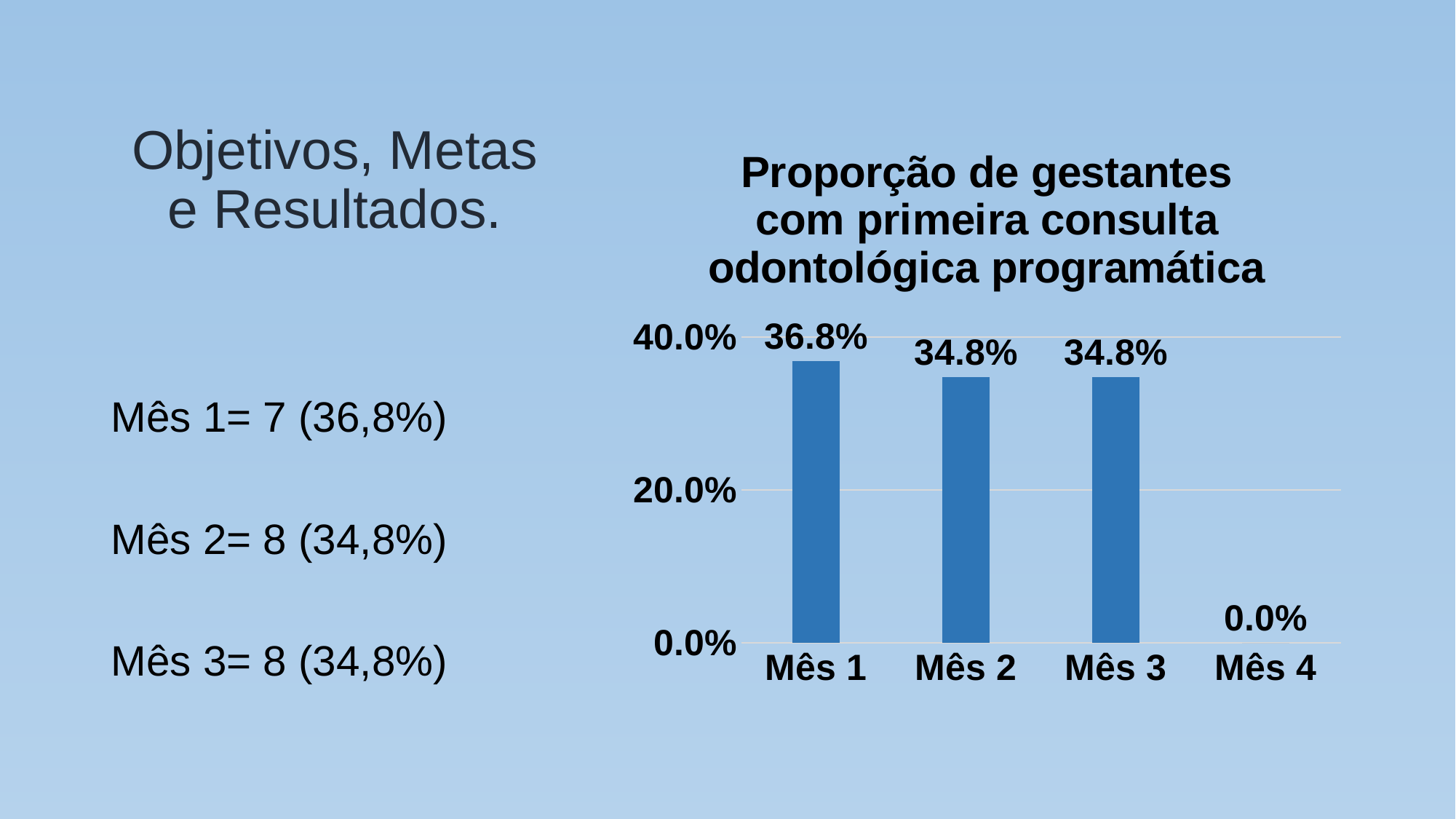
How many categories are shown on the x axis? 4 What is the value for Mês 4? 0.0% What is the title of the chart? Proporção de gestantes com primeira consulta odontológica programática What is the difference between the values for Mês 1 and Mês 2? 2.0% What is the value for Mês 1? 36.8% What kind of chart is shown? bar chart Is the value for Mês 2 greater or less than 20.0%? greater Which category has the highest value? Mês 1 Do the values rise or fall from Mês 1 to Mês 4? fall Which category has the lowest value? Mês 4 Which is larger, the value for Mês 1 or the value for Mês 3? Mês 1 What is the value for Mês 2? 34.8%